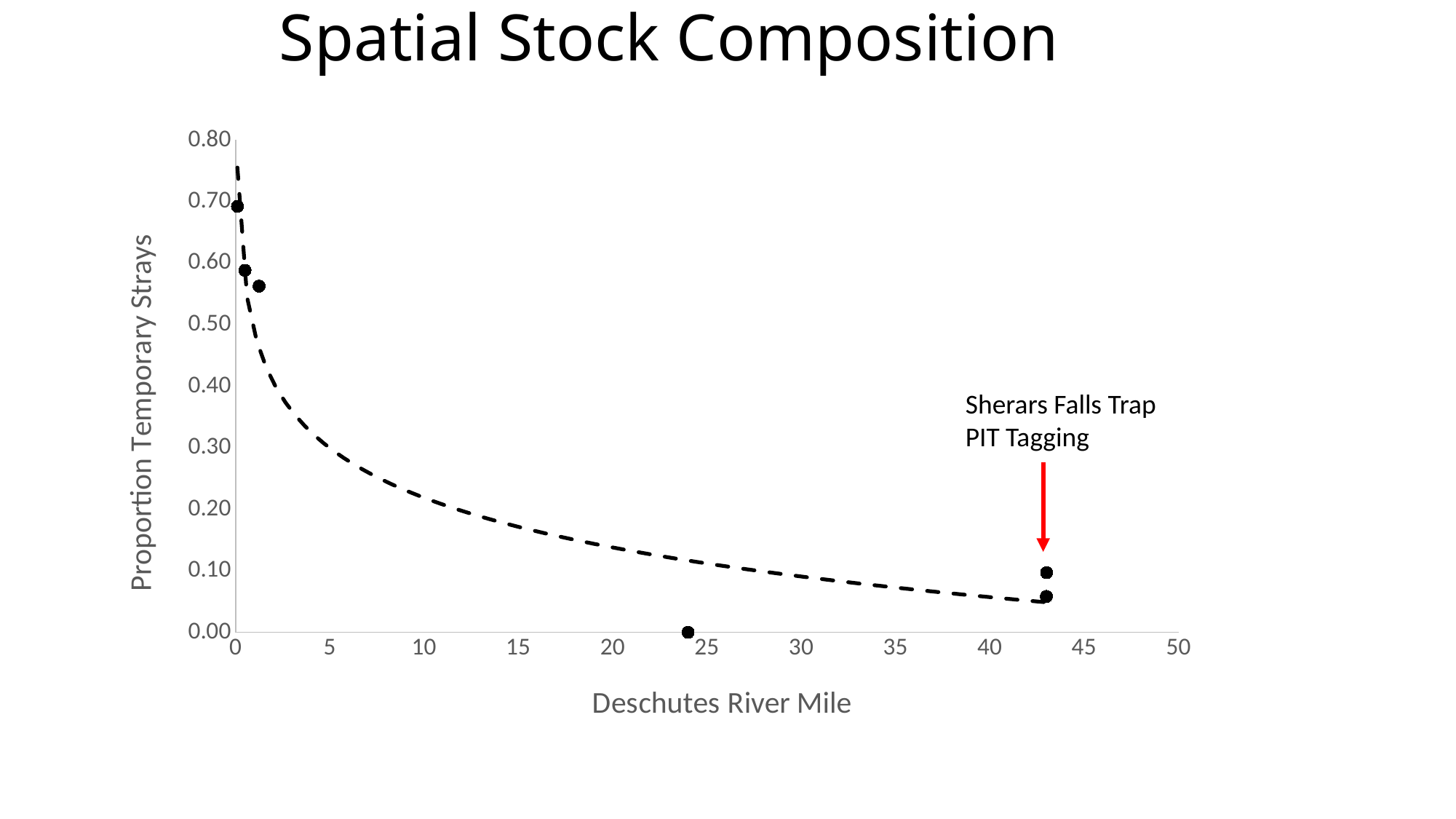
Is the plotted value near river mile 24 greater or less than 0.10? less What is the title of the chart? Spatial Stock Composition Which is larger: the plotted value near river mile 0 or the plotted value near river mile 43? near river mile 0 What is the label of the x axis? Deschutes River Mile Near which river mile is the highest plotted value located? 0 Is the highest plotted value for Proportion Temporary Strays greater or less than 0.60? greater What kind of chart is shown on the slide? scatter chart What does the red arrow annotation on the chart point to? The data points near river mile 43 (labeled Sherars Falls Trap PIT Tagging) Are the plotted values near river mile 43 greater or less than 0.20? less How many data points are plotted on the chart? 6 Do the values of Proportion Temporary Strays rise or fall as Deschutes River Mile increases? fall Near which river mile is the lowest plotted value located? 24